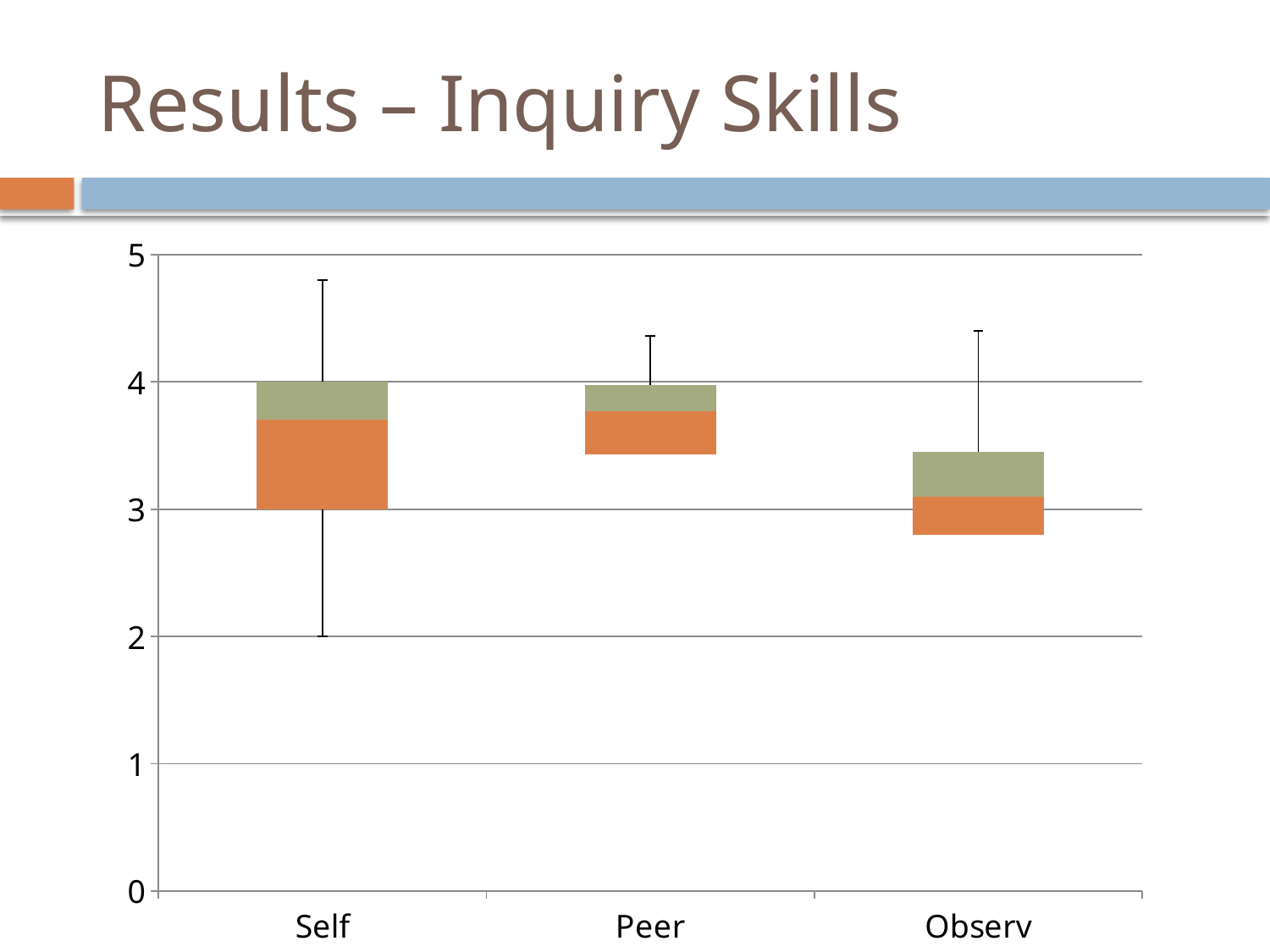
What value does the top of the box for Self reach on the y axis? 4 What kind of chart is shown on the slide? box plot What value does the lower whisker for Self extend down to? 2 Is the bottom of the box for Observ greater or less than 3? less Which category has the highest upper whisker? Self What value does the bottom of the box for Self sit at on the y axis? 3 How many categories are shown on the x axis of the chart? 3 Is the top of the box for Observ greater or less than 4? less Is the bottom of the box for Peer greater or less than 3? greater What are the category labels on the x axis of the chart? Self, Peer, Observ Which category has the lowest bottom of its box? Observ What is the title of the slide containing the chart? Results – Inquiry Skills